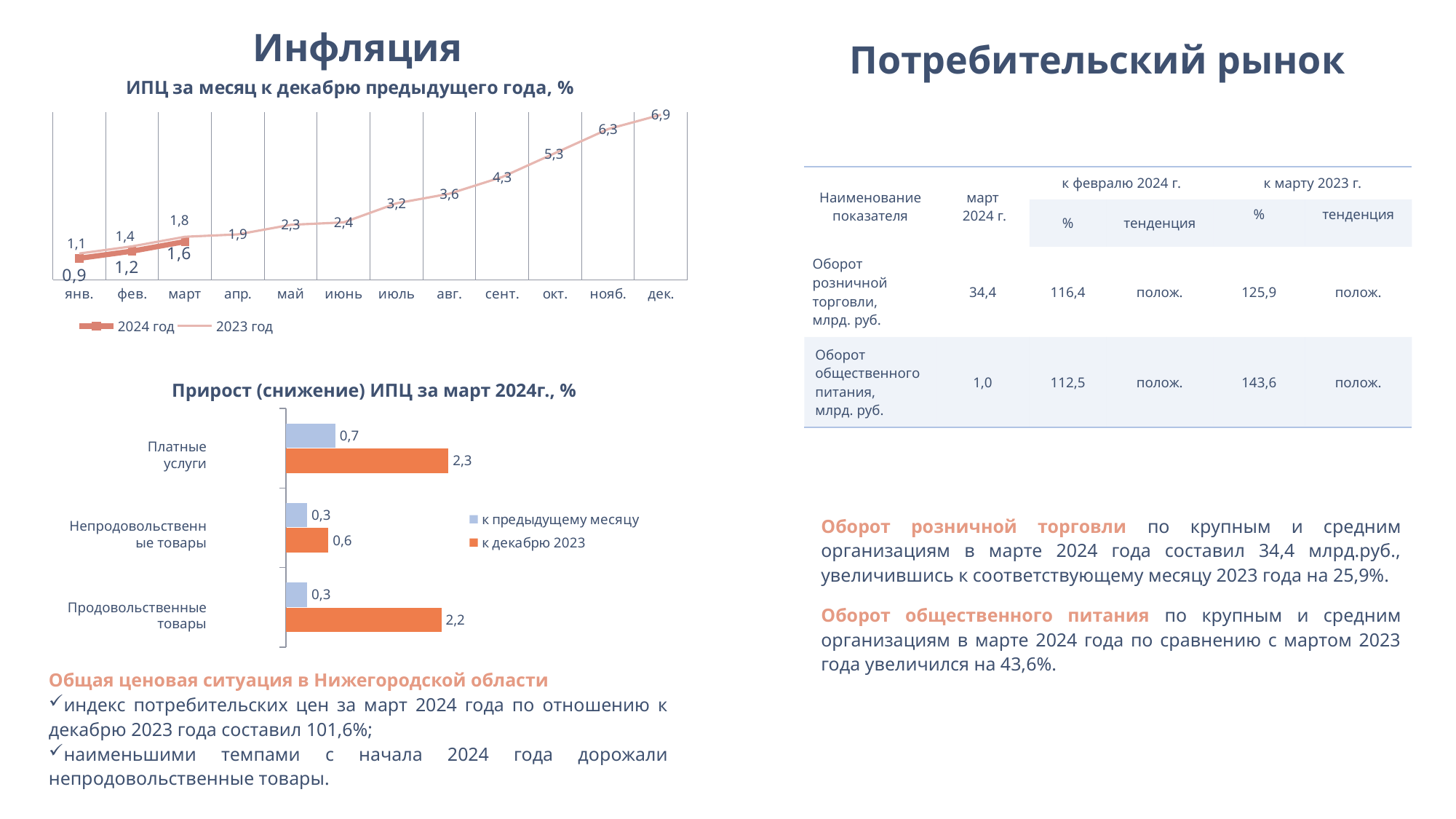
What kind of chart is 'ИПЦ за месяц к декабрю предыдущего года, %'? line chart In the chart 'ИПЦ за месяц к декабрю предыдущего года, %', do the 2023 год values rise or fall from янв. to дек.? rise In the chart 'ИПЦ за месяц к декабрю предыдущего года, %', which month has the highest value for 2023 год? дек. In the chart 'Прирост (снижение) ИПЦ за март 2024г., %', which is larger for Платные услуги: 'к предыдущему месяцу' or 'к декабрю 2023'? к декабрю 2023 In the chart 'ИПЦ за месяц к декабрю предыдущего года, %', what is the value for 2024 год in март? 1,6 In the chart 'Прирост (снижение) ИПЦ за март 2024г., %', what is the value 'к декабрю 2023' for Платные услуги? 2,3 In the chart 'ИПЦ за месяц к декабрю предыдущего года, %', what is the value for 2023 год in дек.? 6,9 In the chart 'Прирост (снижение) ИПЦ за март 2024г., %', what is the difference between the 'к декабрю 2023' and 'к предыдущему месяцу' values for Продовольственные товары? 1,9 In the chart 'ИПЦ за месяц к декабрю предыдущего года, %', what is the difference between the 2023 год and 2024 год values in янв.? 0,2 In the chart 'ИПЦ за месяц к декабрю предыдущего года, %', how many series does the legend list? 2 What kind of chart is 'Прирост (снижение) ИПЦ за март 2024г., %'? bar chart In the chart 'Прирост (снижение) ИПЦ за март 2024г., %', which category has the lowest value 'к декабрю 2023'? Непродовольственные товары